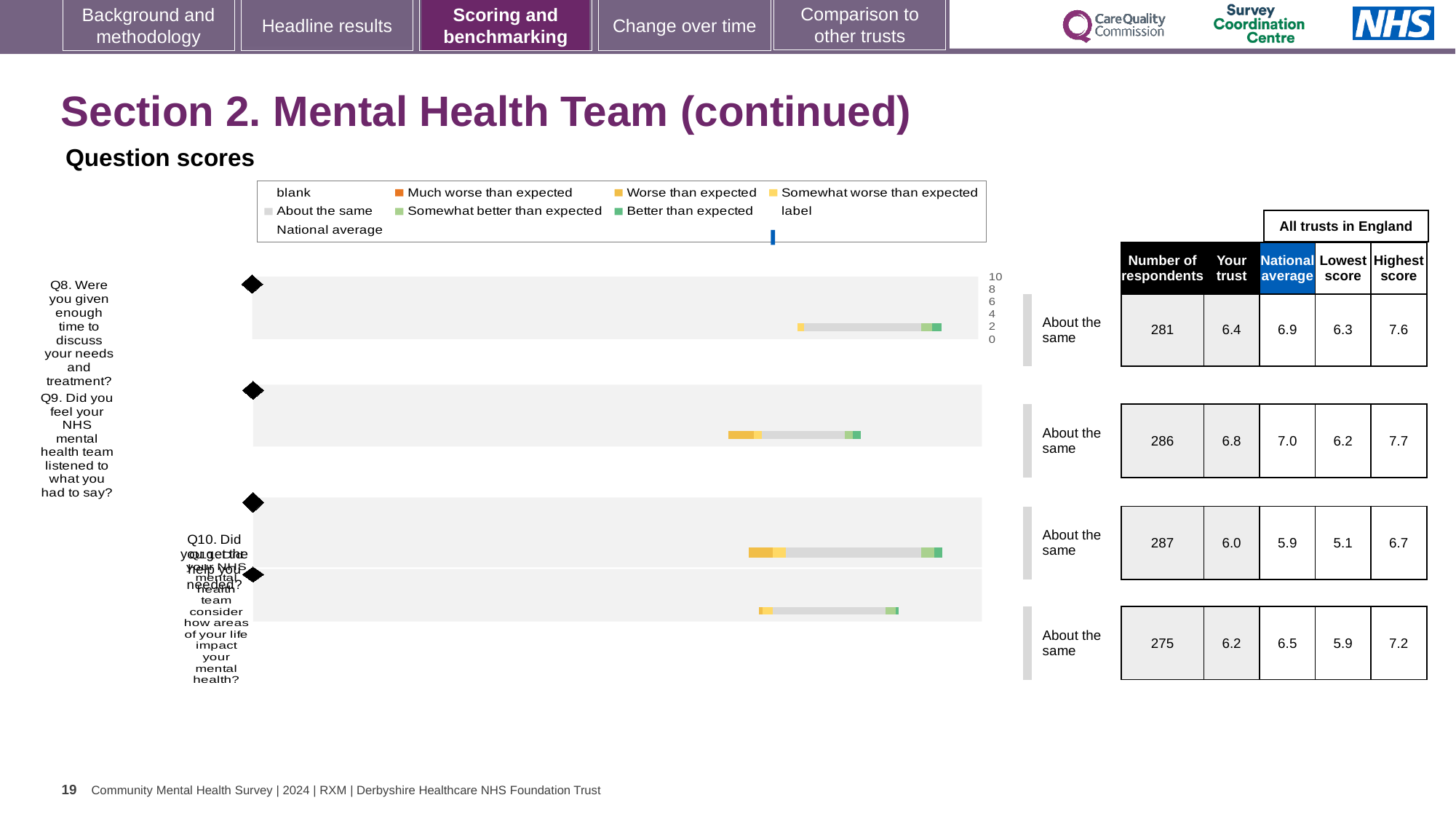
What is the highest score among all trusts in England for Q11 (Did your NHS mental health team consider how areas of your life impact your mental health?)? 7.2 What benchmark category is shown next to each of the four questions in the chart? About the same Which question has the lowest 'Your trust' score? Q10 What is the number of respondents for Q8 (Were you given enough time to discuss your needs and treatment?)? 281 Which question has the highest number of respondents? Q10 What kind of chart is used to show the question scores on this slide? bar chart What is the difference between the highest score and the lowest score for Q8? 1.3 For Q9, which is larger: the 'Your trust' score or the national average? National average What is the 'Your trust' score for Q9 (Did you feel your NHS mental health team listened to what you had to say?)? 6.8 What is the national average score for Q10 (Did you get the help you needed?)? 5.9 How many entries does the legend of the question scores chart list? 9 How many questions (bars) are plotted in the question scores chart? 4